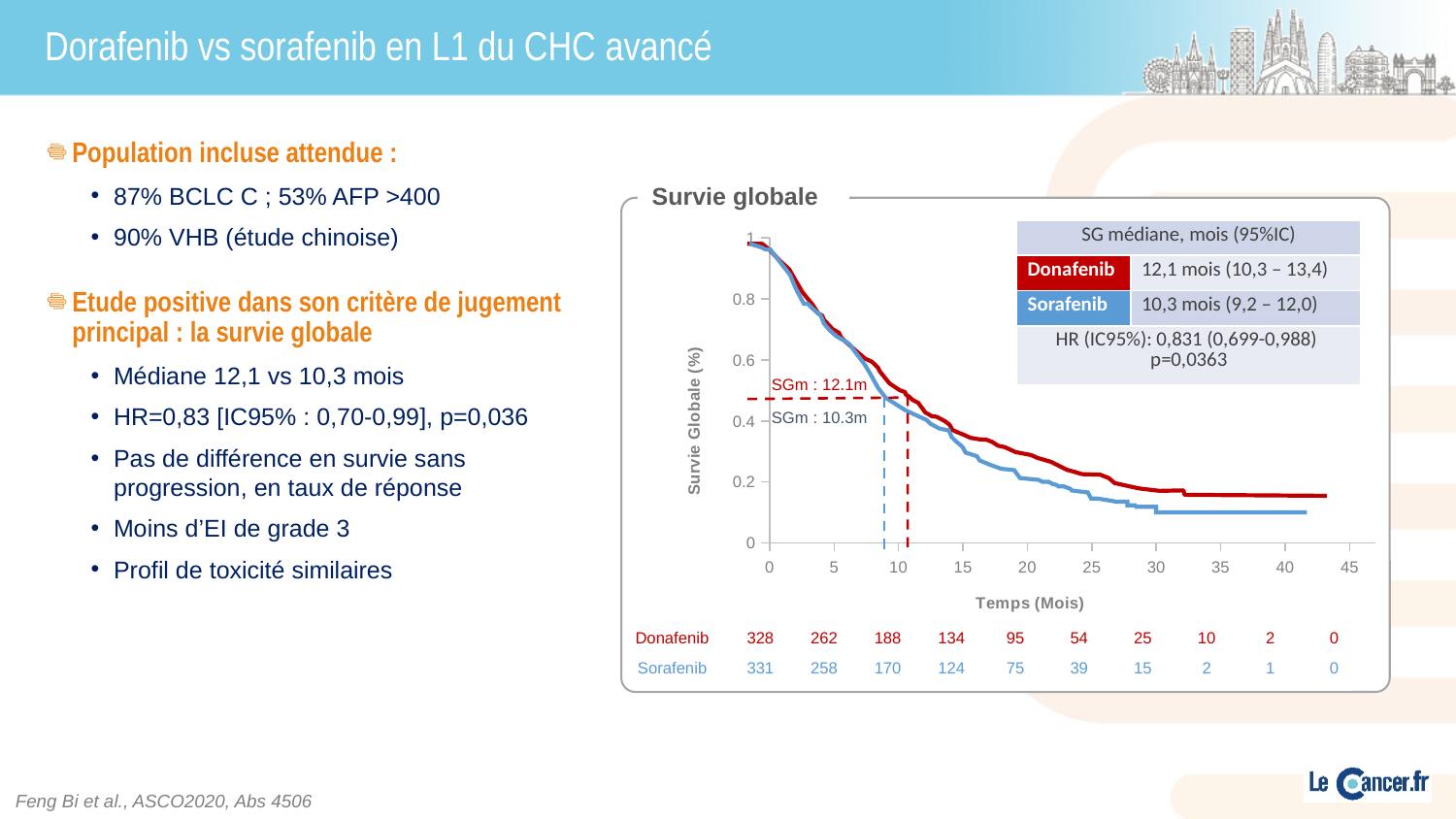
Which arm has more patients at risk at 25 months, Donafenib or Sorafenib? Donafenib How many series (treatment arms) are plotted on the 'Survie globale' chart? 2 In the number-at-risk table, how many Donafenib patients are at risk at 10 months? 188 Is the Sorafenib survival probability at 30 months greater or less than 0.2? less What hazard ratio (HR) is reported on the 'Survie globale' chart? 0,831 (0,699-0,988) According to the table on the chart, what is the median overall survival for Sorafenib? 10,3 mois (9,2 – 12,0) In the number-at-risk table, how many Sorafenib patients are at risk at 20 months? 75 According to the table on the chart, what is the median overall survival for Donafenib? 12,1 mois (10,3 – 13,4) What p-value is shown on the 'Survie globale' chart? p=0,0363 Do the survival curves rise or fall as time (Temps, Mois) increases? Fall What kind of chart is shown under the title 'Survie globale'? Line chart (Kaplan-Meier survival curve) What is the difference between the number of Donafenib and Sorafenib patients at risk at 0 months? 3